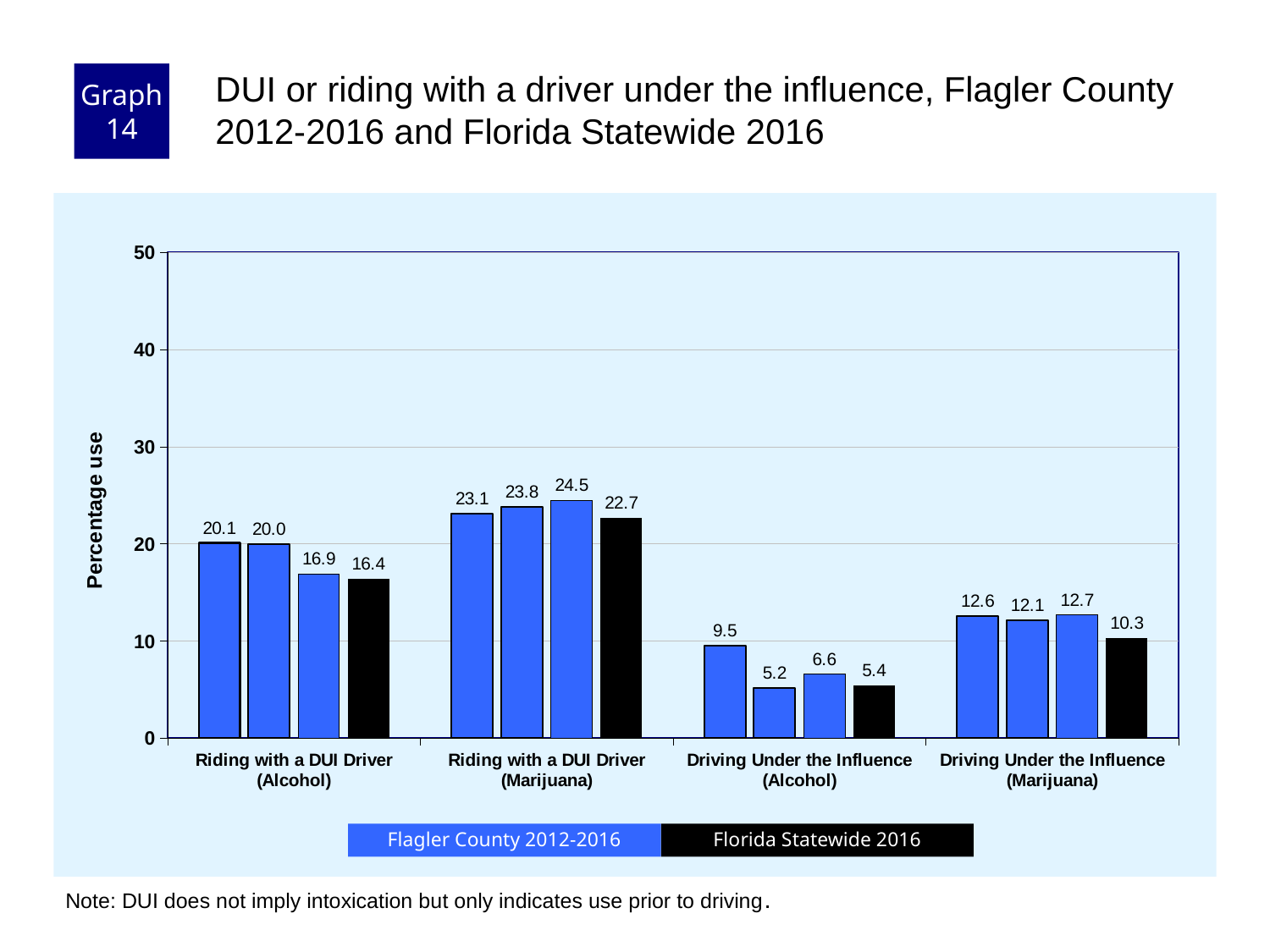
Is the Florida Statewide 2016 value for Riding with a DUI Driver (Marijuana) greater or less than 20? greater Which is larger for Florida Statewide 2016: Riding with a DUI Driver (Alcohol) or Driving Under the Influence (Marijuana)? Riding with a DUI Driver (Alcohol) What is the highest data label shown anywhere on the chart? 24.5 What is the highest value shown for any Flagler County 2012-2016 bar in the Driving Under the Influence (Alcohol) category? 9.5 In which category is the Florida Statewide 2016 value lowest? Driving Under the Influence (Alcohol) How many categories are shown on the x axis? 4 How many series does the legend list? 2 What is the difference between the Florida Statewide 2016 values for Riding with a DUI Driver (Marijuana) and Riding with a DUI Driver (Alcohol)? 6.3 What is the Florida Statewide 2016 value for Riding with a DUI Driver (Alcohol)? 16.4 What kind of chart is shown on the slide? bar chart In which category is the Florida Statewide 2016 value highest? Riding with a DUI Driver (Marijuana) What is the Florida Statewide 2016 value for Driving Under the Influence (Marijuana)? 10.3